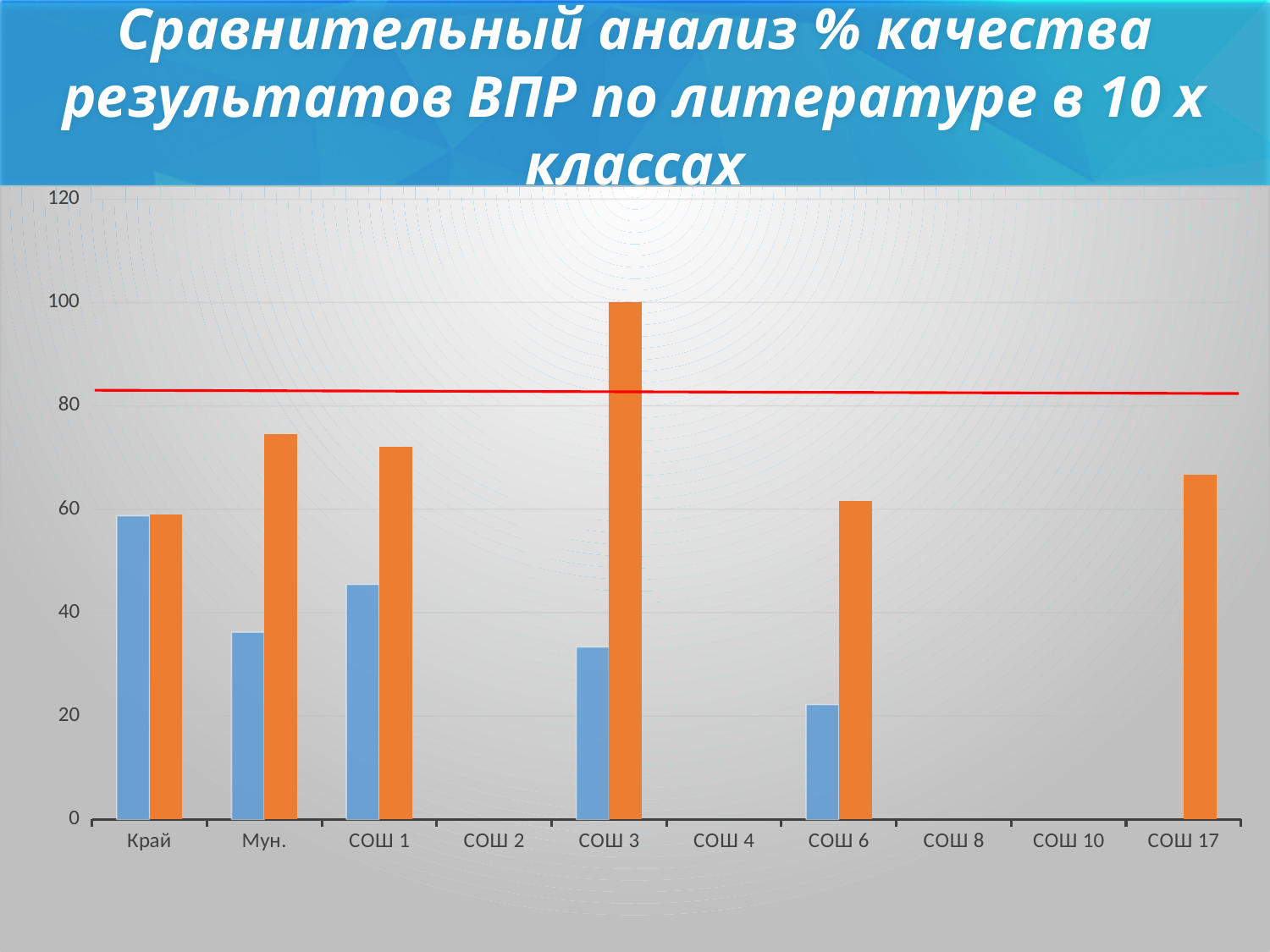
Is the orange bar for Мун. greater or less than 80? less Is the orange bar for СОШ 17 greater or less than 60? greater What kind of chart is shown on the slide? bar chart What is the value of the orange bar for СОШ 3? 100 Is the blue bar for СОШ 3 greater or less than 40? less Which category has the tallest orange bar? СОШ 3 How many categories on the x axis have no bars at all? 4 How many categories are shown on the x axis? 10 Which is larger, the blue bar for Край or the blue bar for Мун.? Край Which category has the tallest blue bar? Край Among the categories that have a blue bar, which has the shortest blue bar? СОШ 6